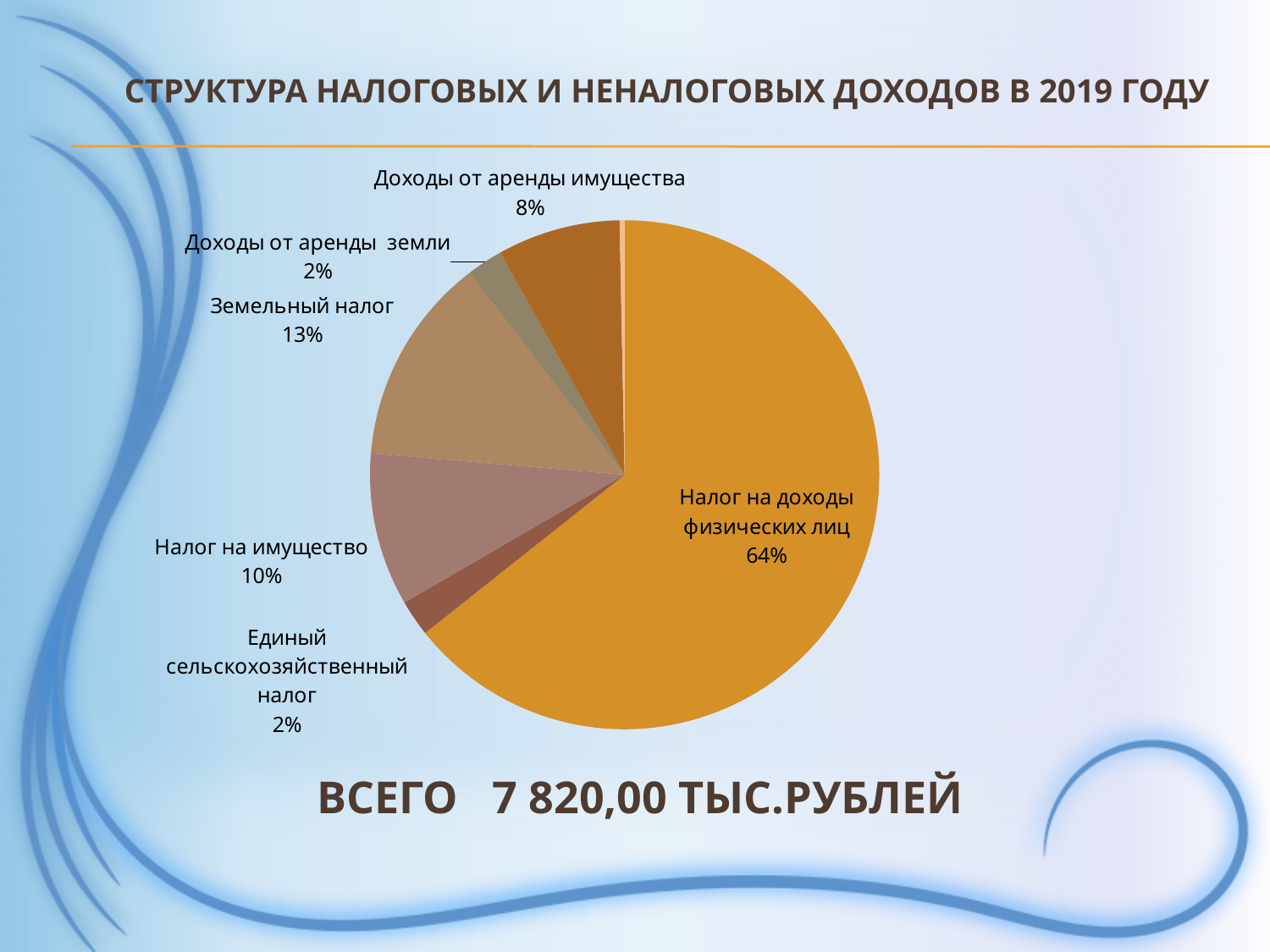
Which is larger, Земельный налог or Налог на имущество? Земельный налог What is the title of the slide? СТРУКТУРА НАЛОГОВЫХ И НЕНАЛОГОВЫХ ДОХОДОВ В 2019 ГОДУ What type of chart is shown on the slide? Pie chart What percentage is shown for Единый сельскохозяйственный налог? 2% What percentage is shown for Доходы от аренды имущества? 8% What percentage is shown for Доходы от аренды земли? 2% What percentage is shown for Земельный налог? 13% What share of the pie does Налог на доходы физических лиц represent? 64% Which category has the largest share of the pie? Налог на доходы физических лиц What total amount is stated below the chart? 7 820,00 тыс.рублей What percentage is shown for Налог на имущество? 10% By how many percentage points does Налог на доходы физических лиц exceed Земельный налог? 51 percentage points